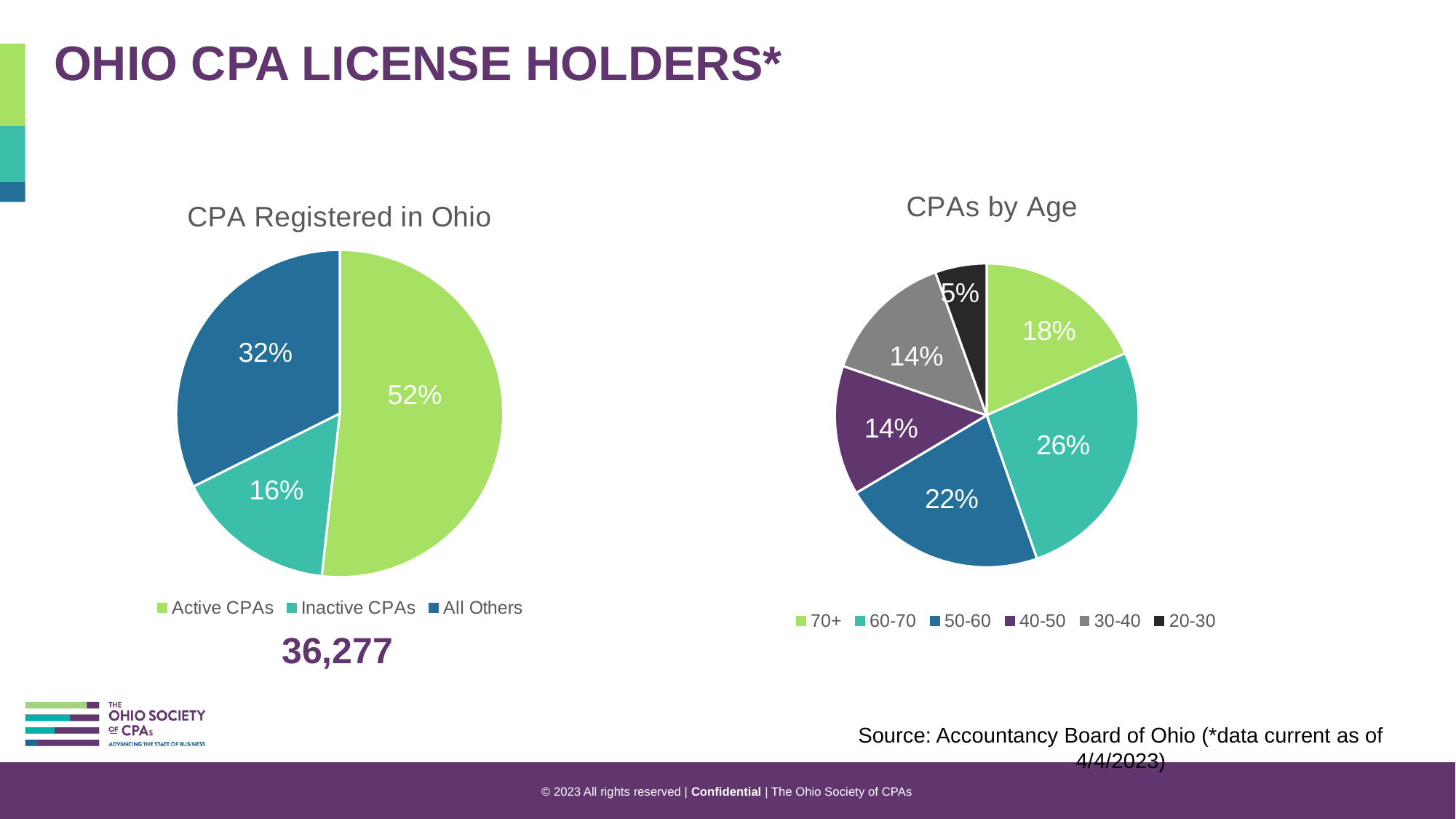
What total number is printed below the 'CPA Registered in Ohio' chart? 36,277 In the 'CPAs by Age' chart, how many age groups are shown? 6 What kind of chart is 'CPAs by Age'? Pie chart In the 'CPA Registered in Ohio' chart, what percentage is shown for Active CPAs? 52% In the 'CPA Registered in Ohio' chart, what percentage is shown for Inactive CPAs? 16% In the 'CPA Registered in Ohio' chart, how many categories does the legend list? 3 In the 'CPAs by Age' chart, what percentage is shown for the 20-30 age group? 5% In the 'CPA Registered in Ohio' chart, what is the difference in percentage points between Active CPAs and All Others? 20 In the 'CPAs by Age' chart, which is larger, the 70+ slice or the 50-60 slice? 50-60 In the 'CPAs by Age' chart, what percentage is shown for the 60-70 age group? 26% In the 'CPAs by Age' chart, which age group has the largest share? 60-70 In the 'CPA Registered in Ohio' chart, which category has the smallest slice? Inactive CPAs